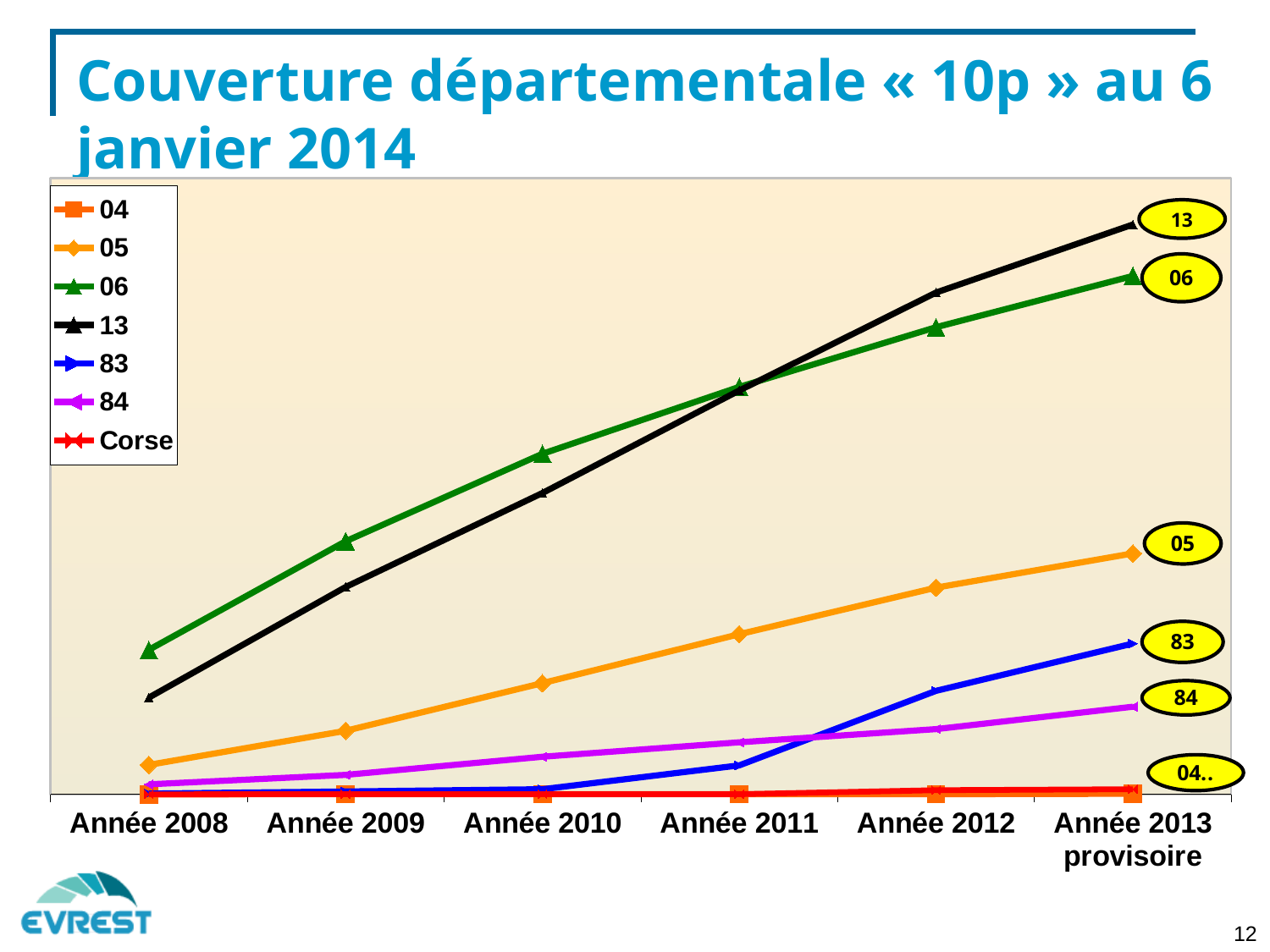
How many series does the legend list? 7 Does the value for series 13 rise or fall from Année 2008 to Année 2013 provisoire? rise In Année 2012, which series is higher, 83 or 84? 83 What kind of chart is shown on the slide? line chart Which series has the highest value in Année 2013 provisoire? 13 How many years are shown along the x axis? 6 In Année 2010, which series is higher, 83 or 84? 84 Which series has the highest value in Année 2008? 06 What is the label of the last category on the x axis? Année 2013 provisoire Does the value for series 05 rise or fall across the years shown? rise In Année 2012, which series is higher, 13 or 06? 13